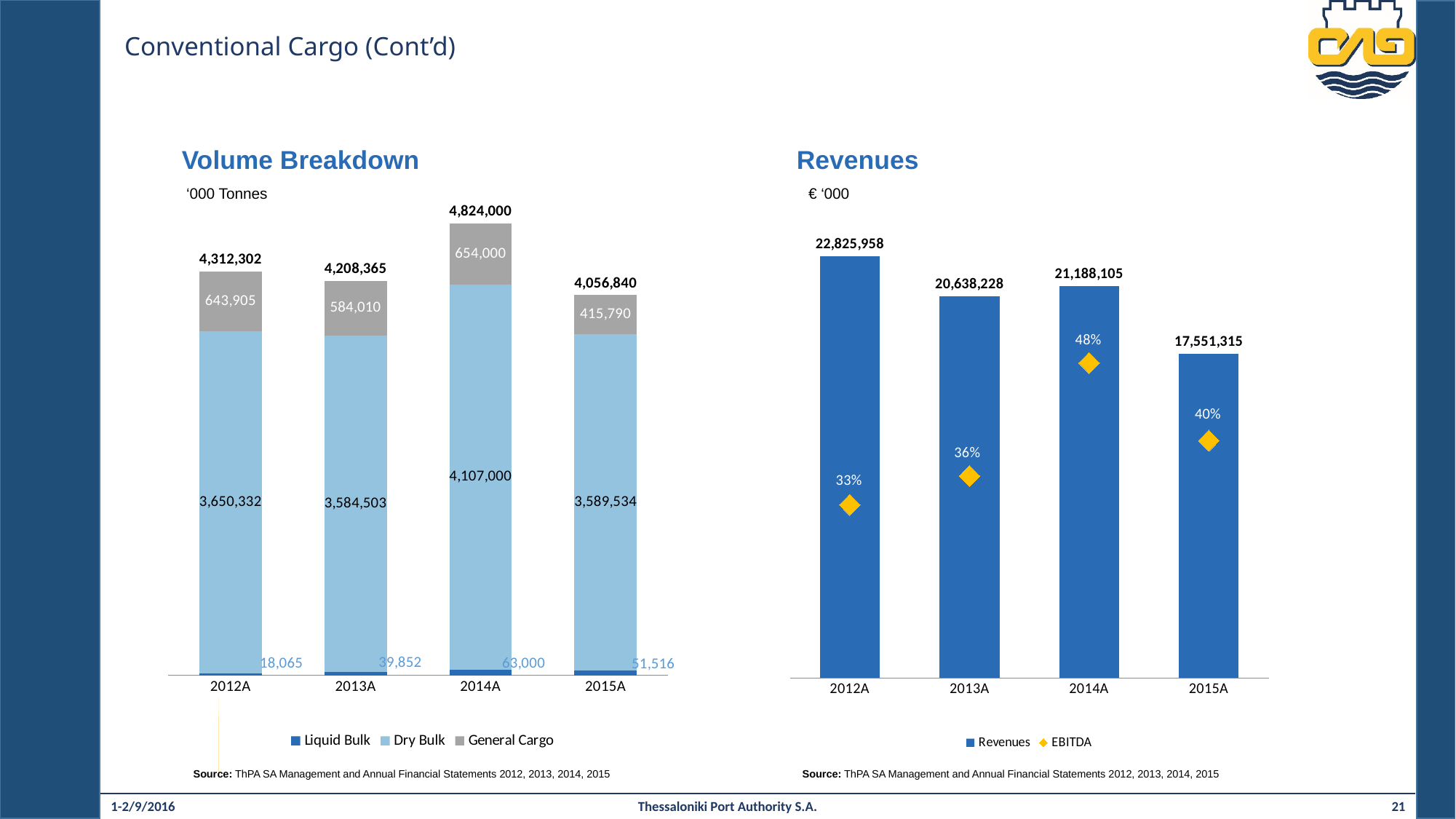
In the Volume Breakdown chart, what is the total of the stacked bar for 2012A? 4,312,302 In the Volume Breakdown chart, which year has the highest total volume? 2014A In the Revenues chart, how many years are shown on the x axis? 4 In the Revenues chart, what is the Revenues value for 2013A? 20,638,228 In the Revenues chart, which year has the lowest Revenues? 2015A In the Volume Breakdown chart, how many series does the legend list? 3 In the Revenues chart, what is the difference between Revenues in 2012A and 2015A? 5,274,643 In the Volume Breakdown chart, what is the Dry Bulk value for 2014A? 4,107,000 In the Volume Breakdown chart, what is the difference between the General Cargo values for 2012A and 2013A? 59,895 In the Volume Breakdown chart, what is the Liquid Bulk value for 2013A? 39,852 In the Volume Breakdown chart, what is the General Cargo value for 2015A? 415,790 In the Revenues chart, what is the EBITDA percentage for 2014A? 48%